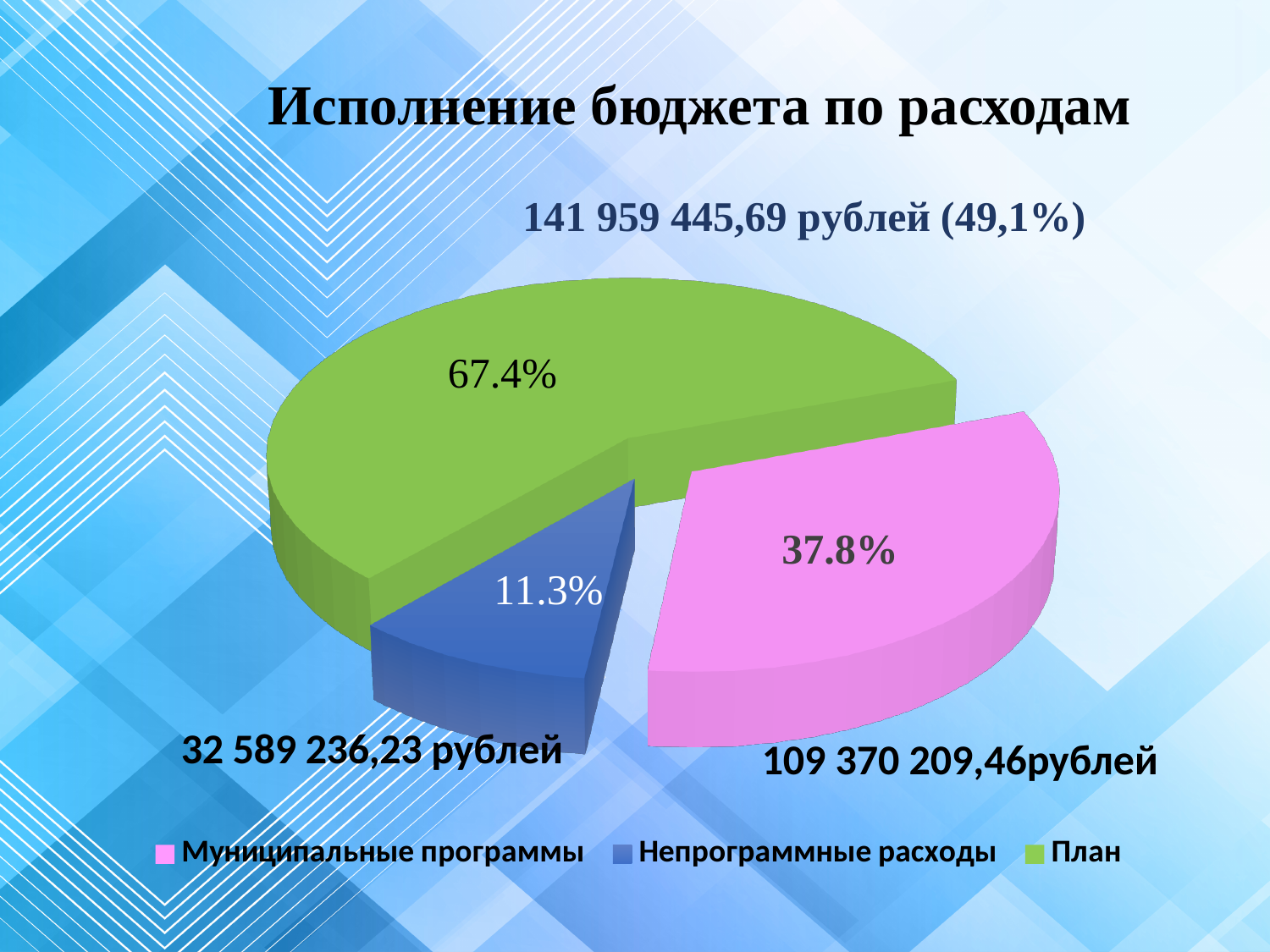
What amount in rubles is labelled next to the Непрограммные расходы slice? 32 589 236,23 рублей How many entries does the legend list? 3 What kind of chart is shown on the slide? pie chart What is the title of the chart? 141 959 445,69 рублей (49,1%) What percentage is shown on the slice for Непрограммные расходы? 11.3% Which slice of the pie is the smallest? Непрограммные расходы What amount in rubles is labelled next to the Муниципальные программы slice? 109 370 209,46 рублей Which slice has the larger share: Муниципальные программы or Непрограммные расходы? Муниципальные программы Which slice of the pie is the largest? План How many slices does the pie chart have? 3 What percentage is shown on the slice for План? 67.4% What percentage is shown on the slice for Муниципальные программы? 37.8%